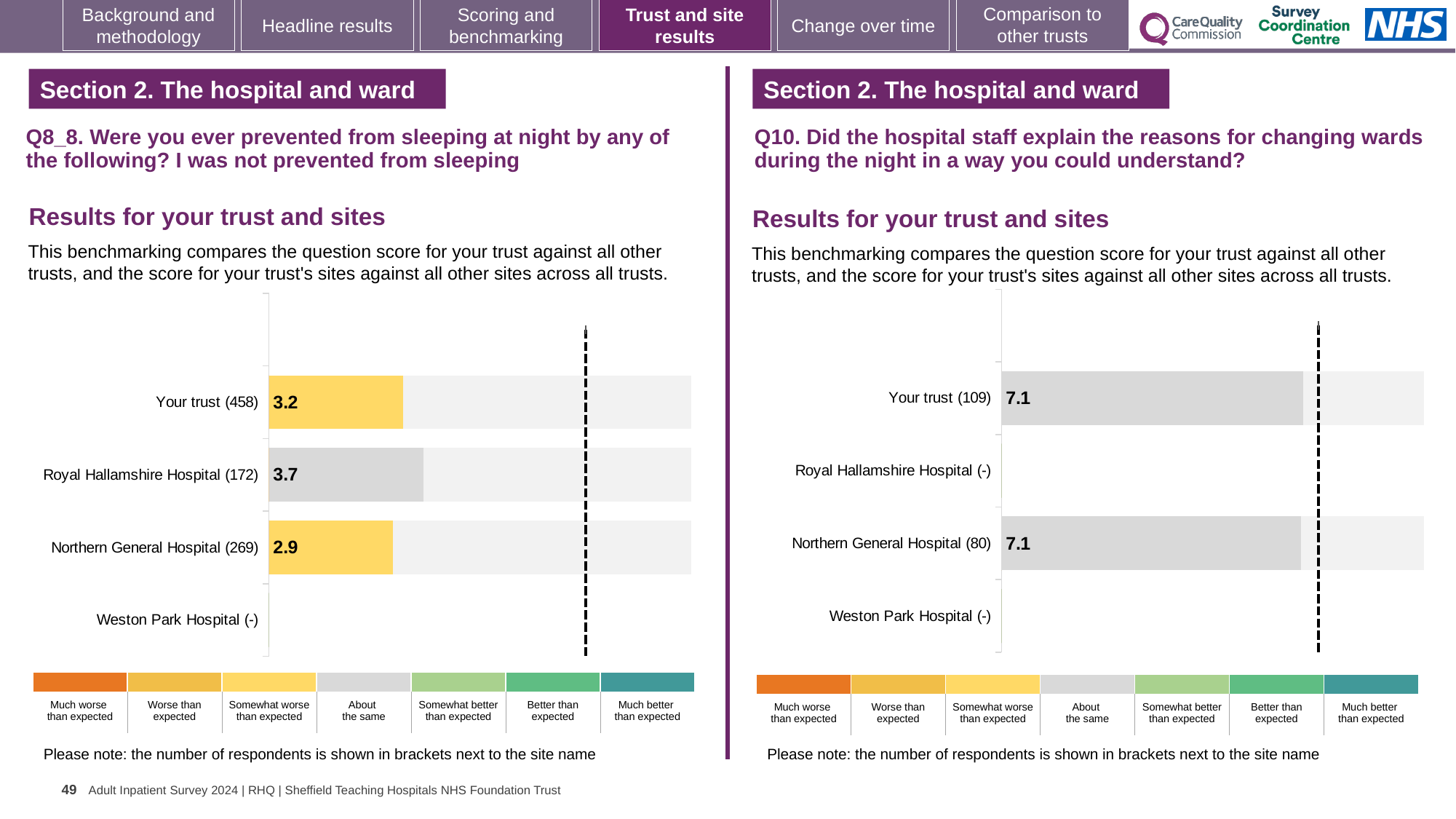
In the Q8_8 chart on the left, which site has the lowest score among those with a score shown? Northern General Hospital In the Q8_8 chart on the left, what is the score for Royal Hallamshire Hospital? 3.7 What kind of chart is used in the Q10 chart on the right? Bar chart In the Q10 chart on the right, what is the score for Northern General Hospital? 7.1 In the Q10 chart on the right, how many respondents are shown in brackets for Northern General Hospital? 80 How many site rows (including Your trust) are listed in the Q8_8 chart on the left? 4 In the Q8_8 chart on the left, which has the larger score: Your trust or Royal Hallamshire Hospital? Royal Hallamshire Hospital In the Q8_8 chart on the left, what is the difference between the scores for Royal Hallamshire Hospital and Northern General Hospital? 0.8 In the Q10 chart on the right, what is the score for Your trust? 7.1 In the Q8_8 chart on the left, what is the score for Northern General Hospital? 2.9 In the Q8_8 chart on the left, what is the score for Your trust? 3.2 In the Q8_8 chart on the left, which site has the highest score? Royal Hallamshire Hospital